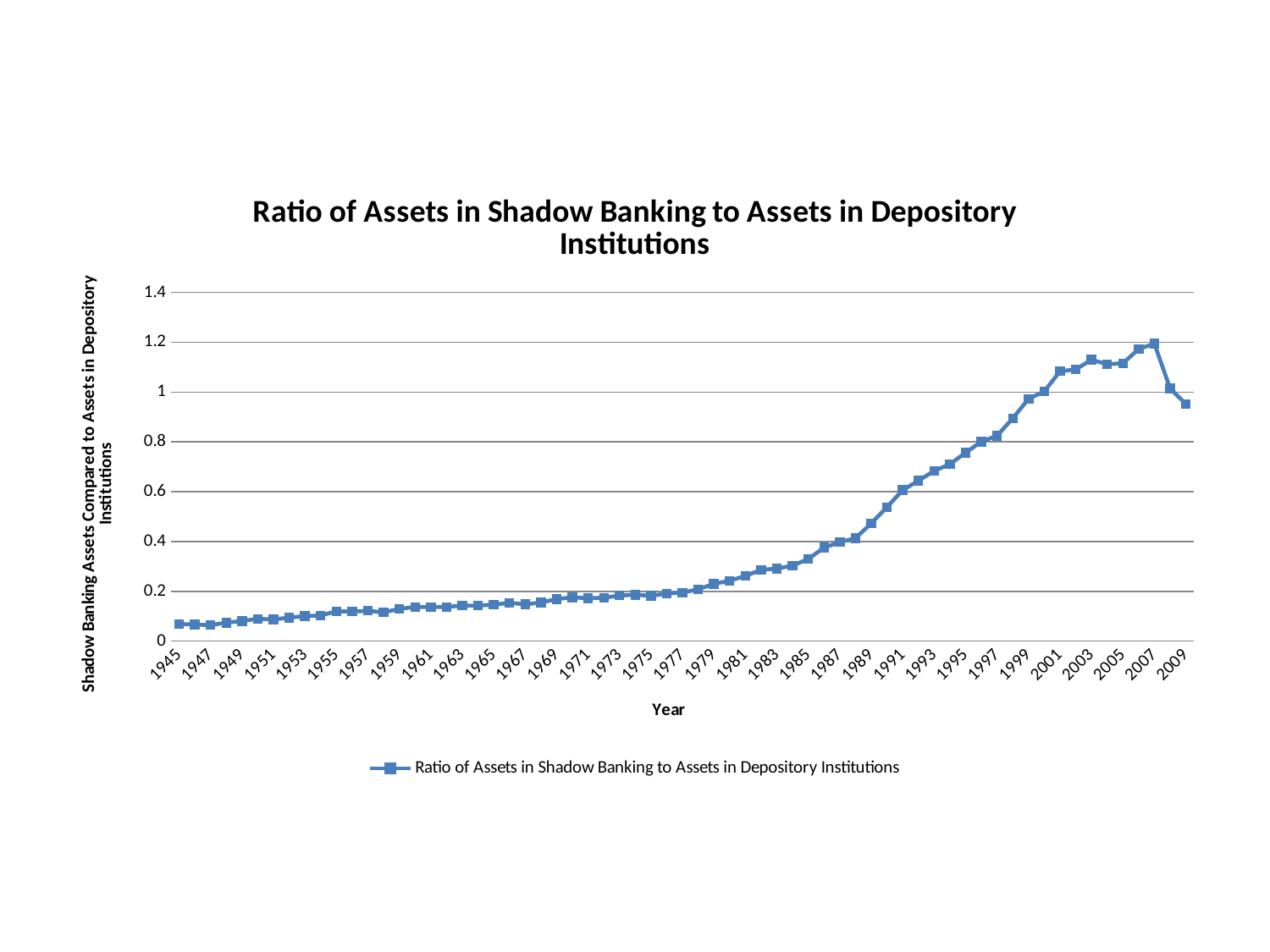
Which year has the larger value, 2007 or 2009? 2007 Overall, do the values rise or fall from 1945 to 2007? rise In which year does the ratio reach its highest value? 2007 Do the values rise or fall between 2007 and 2009? fall What is the label of the x axis? Year What is the title of the chart? Ratio of Assets in Shadow Banking to Assets in Depository Institutions Is the value for 1985 greater or less than 0.4? less Is the value for 1985 greater or less than 0.2? greater Is the value for 1965 greater or less than 0.2? less What kind of chart is shown on the slide? line chart How many series does the legend list? 1